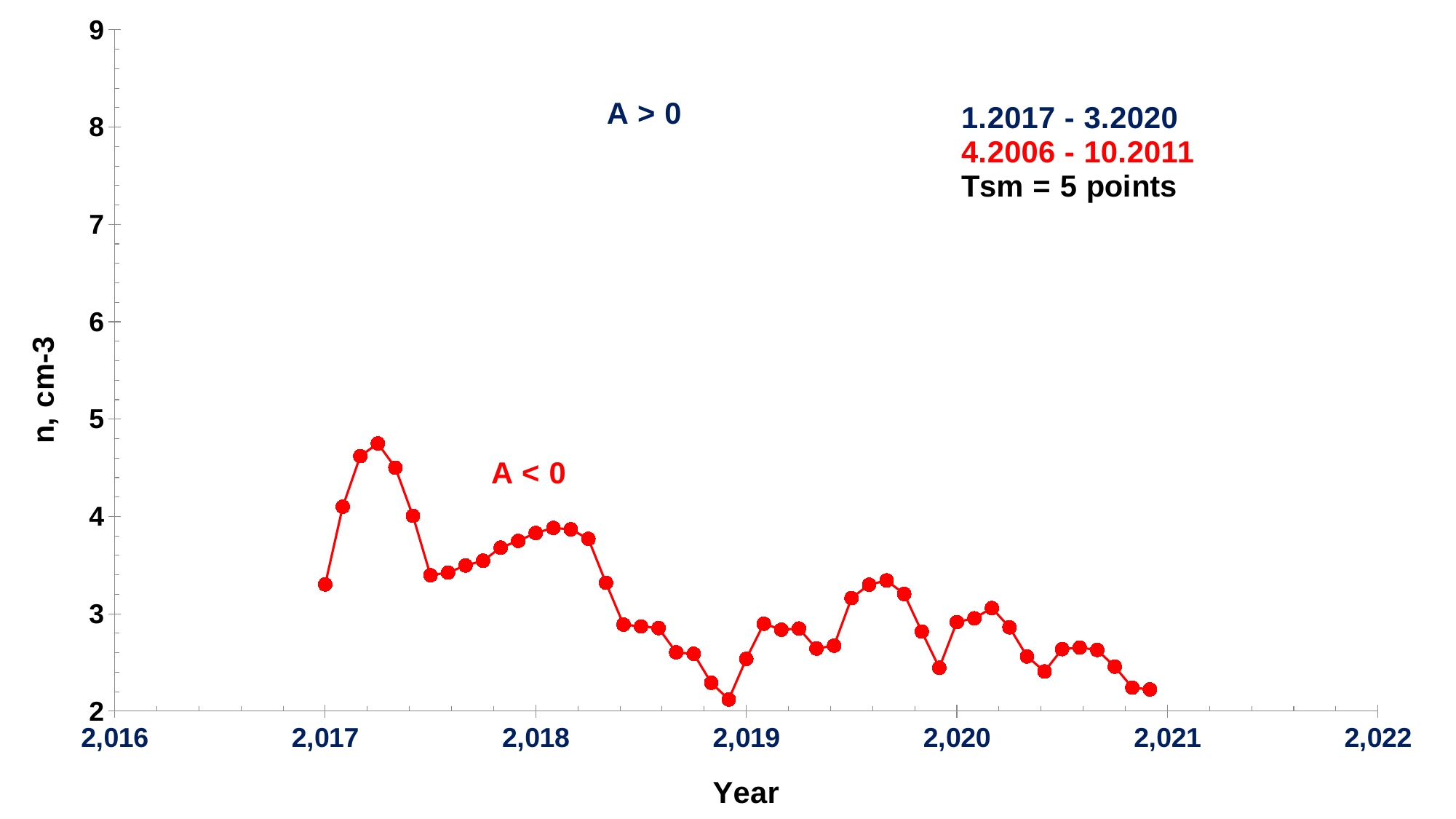
Is the value at the start of the series, at 2,017, greater or less than 3? greater Which is larger, the value at 2,017 or the value at 2,019? the value at 2,017 What kind of chart is shown on the slide? line chart Is the value at 2,020 greater or less than 3? less Is the highest value of the series greater or less than 4? greater How many data series are plotted on the chart? 1 Overall, do the values rise or fall from 2,017 to 2,021? fall What is the label of the x axis? Year What is the label of the y axis? n, cm-3